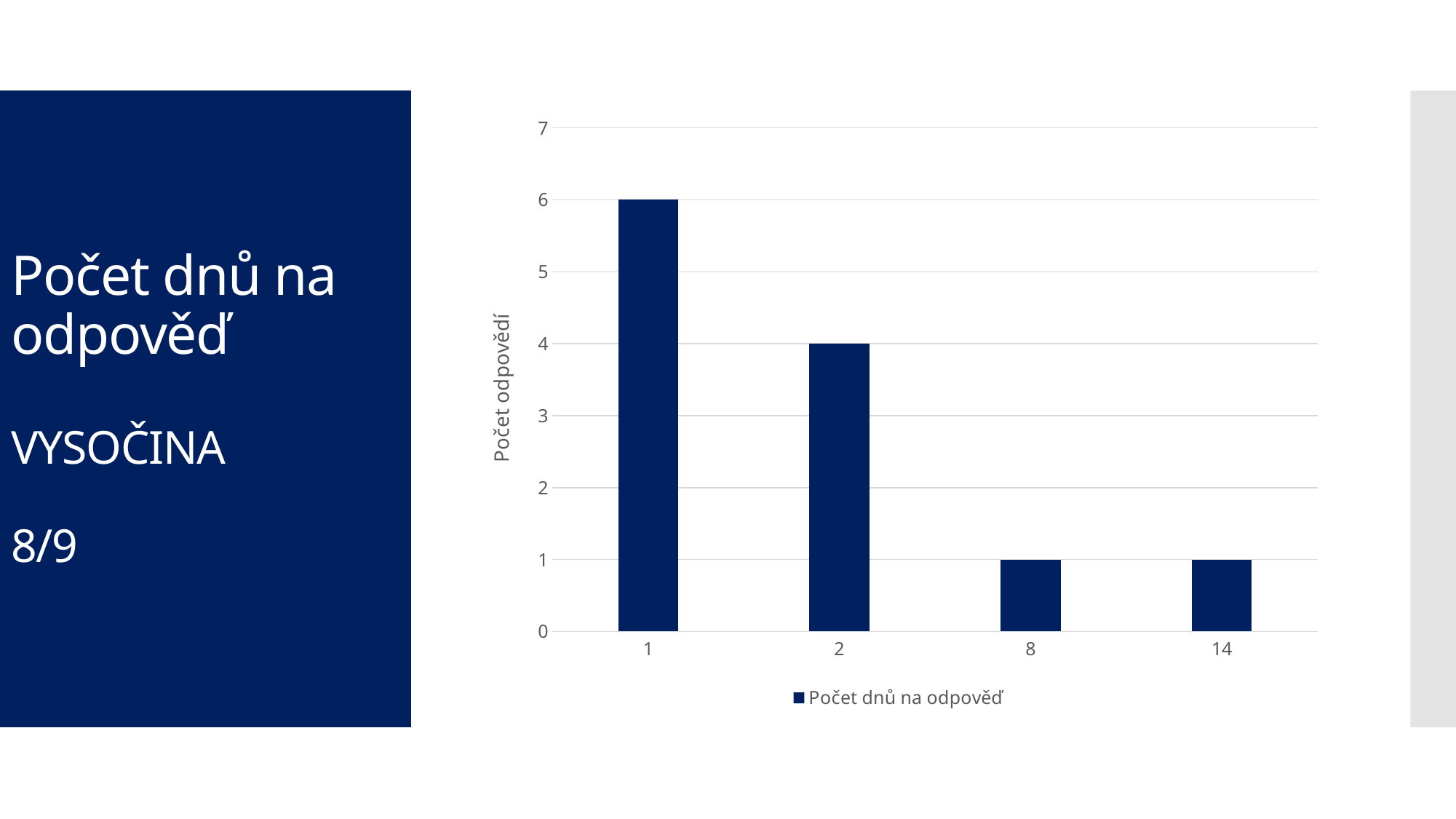
What is the value (Počet odpovědí) for category 2? 4 What is the label of the vertical axis? Počet odpovědí What is the value (Počet odpovědí) for category 8? 1 What is the value (Počet odpovědí) for category 1? 6 Which has a larger value, category 2 or category 14? 2 Do the values rise or fall from left to right along the x axis? fall Which category has the highest value? 1 How many series does the legend list? 1 Is the value for category 1 greater or less than 5? greater What is the difference between the values for category 1 and category 2? 2 How many bars (categories) does the chart show? 4 What type of chart is shown on the slide? bar chart